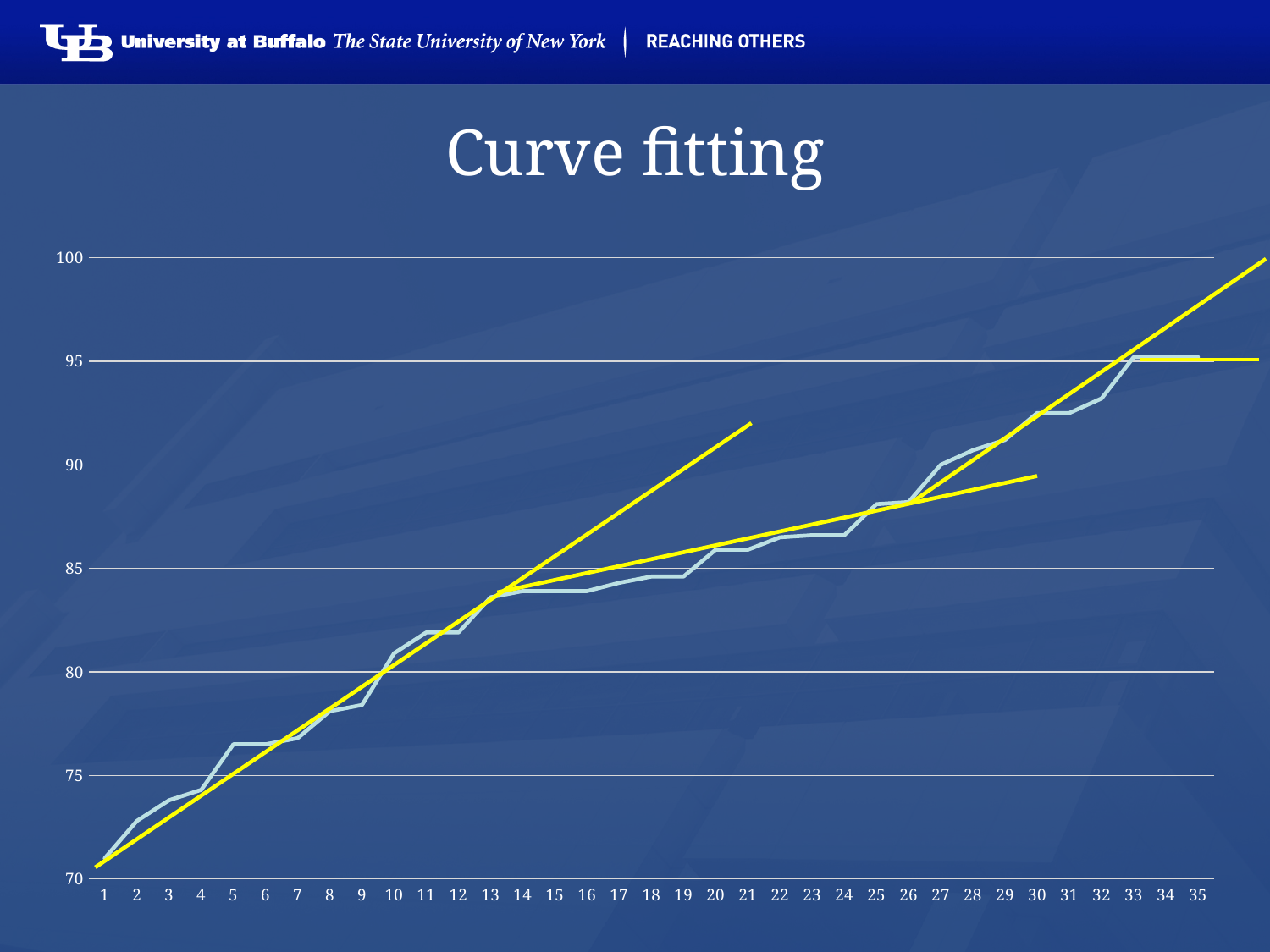
Is the value of the light blue line at x = 13 greater or less than 80? greater How many points are plotted along the x axis of the chart? 35 What kind of chart is shown on the slide? line chart Is the value of the light blue line at x = 30 greater or less than 90? greater Is the value of the light blue line at x = 9 greater or less than 80? less At which x value is the light blue line lowest? 1 Do the values of the light blue line rise or fall as the x axis goes from 1 to 35? rise What is the title of the chart on the slide? Curve fitting How many yellow straight lines are drawn over the light blue data line? 4 Which is larger, the value of the light blue line at x = 5 or at x = 25? x = 25